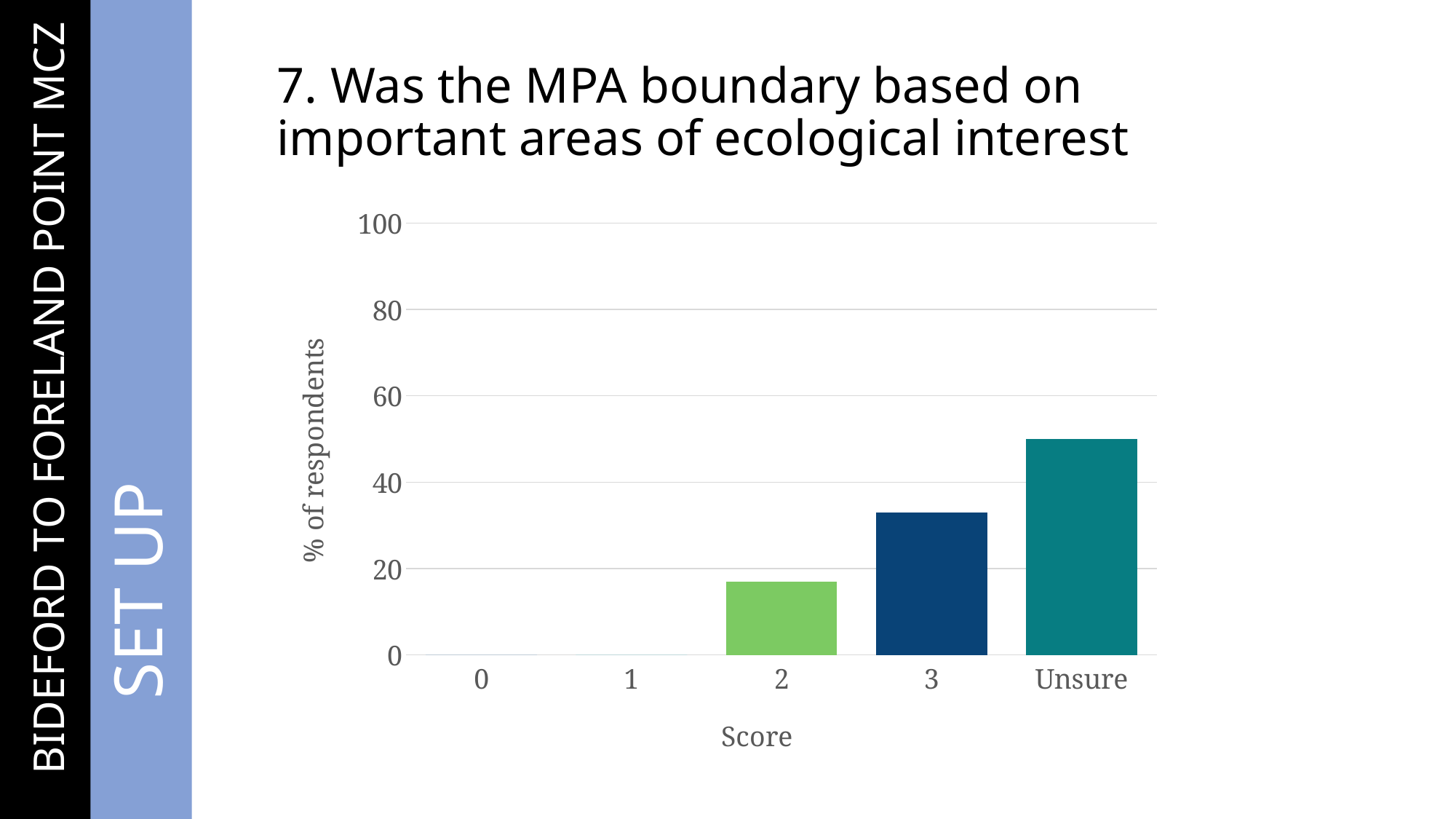
Is the value for score 2 greater or less than 20? less Is the value for score 3 greater or less than 40? less Do the values rise or fall moving from score 2 to Unsure along the x axis? rise What kind of chart is shown on the slide? bar chart Is the value for Unsure greater or less than 60? less What is the label on the y axis of the chart? % of respondents Which category has the highest percentage of respondents? Unsure How many categories are shown on the x axis of the chart? 5 Which is larger, the value for score 2 or the value for score 3? score 3 What is the label on the x axis of the chart? Score